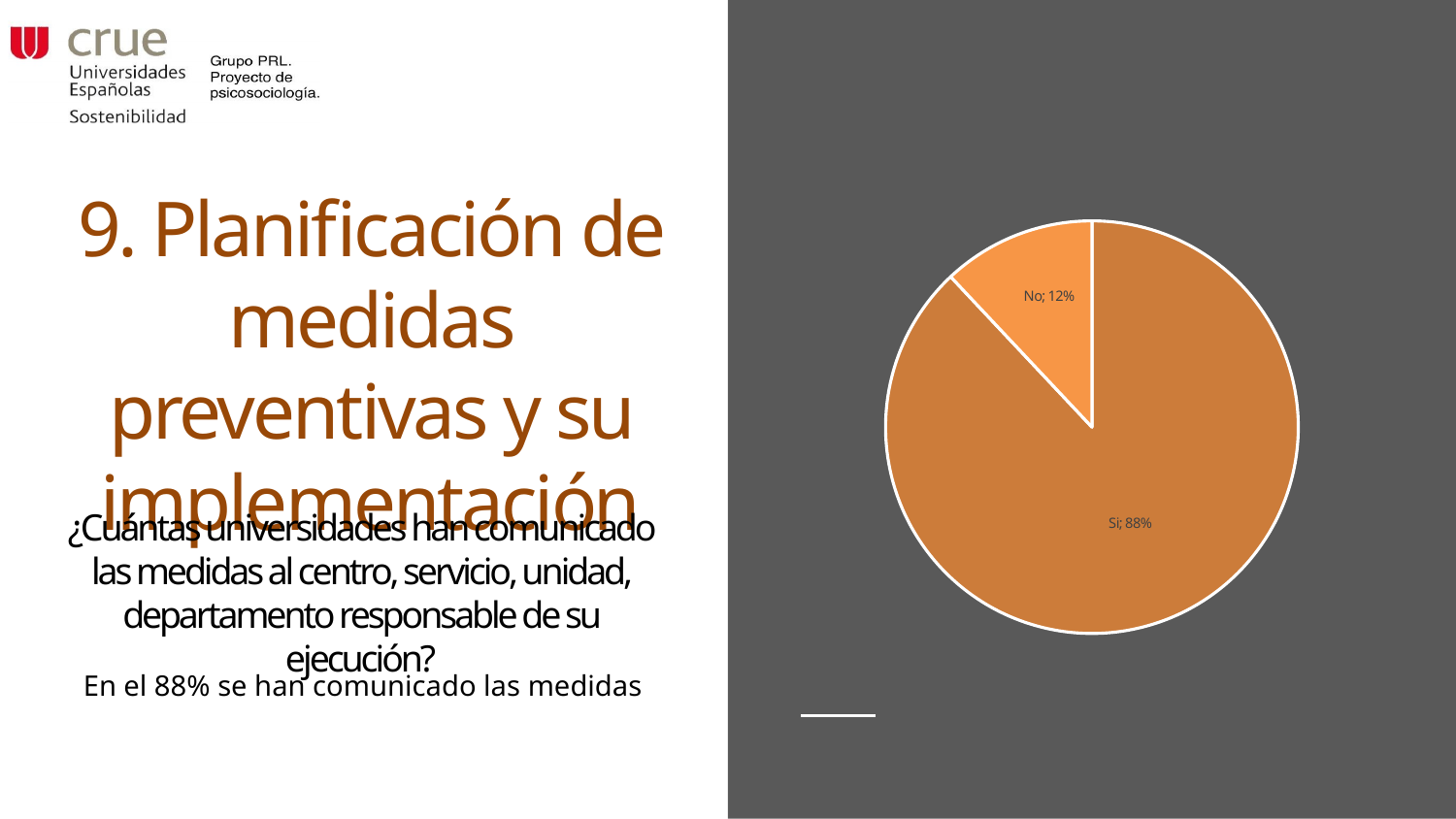
What is the difference in percentage points between the "Si" and "No" slices? 76 What is the total of the two slice percentages shown on the pie chart? 100% What share of the pie does the "No" slice represent? 12% What share of the pie does the "Si" slice represent? 88% What kind of chart is shown on the slide? pie chart Which slice of the pie is the smallest? No Which slice of the pie is shown in the lighter orange colour? No How many slices does the pie chart have? 2 Which is larger, the "Si" slice or the "No" slice? Si Which slice of the pie is the largest? Si